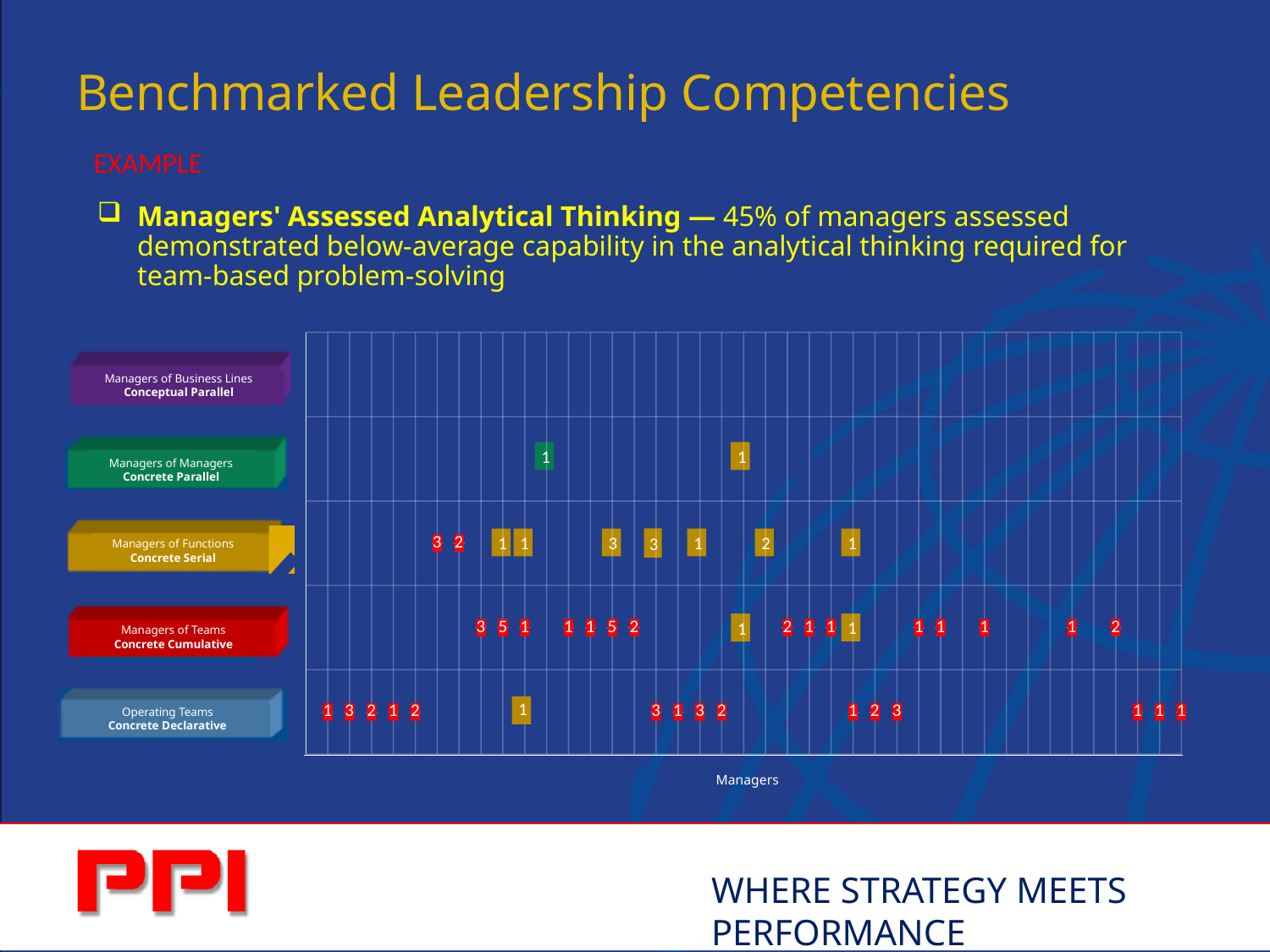
What competency label is shown under Managers of Functions? Concrete Serial What is the title of the x axis of the chart? Managers What is the leftmost data label in the Operating Teams row? 1 How many row categories are listed down the left side of the chart? 5 What value is shown on the data labels in the Managers of Managers row? 1 What kind of chart is shown on the slide? scatter chart What is the leftmost data label in the Managers of Functions row? 3 Which row category of the chart has no data points plotted? Managers of Business Lines What is the largest value shown on any data label in the chart? 5 How many data points are plotted in the Managers of Managers row? 2 In which row do the data points labeled 5 appear? Managers of Teams